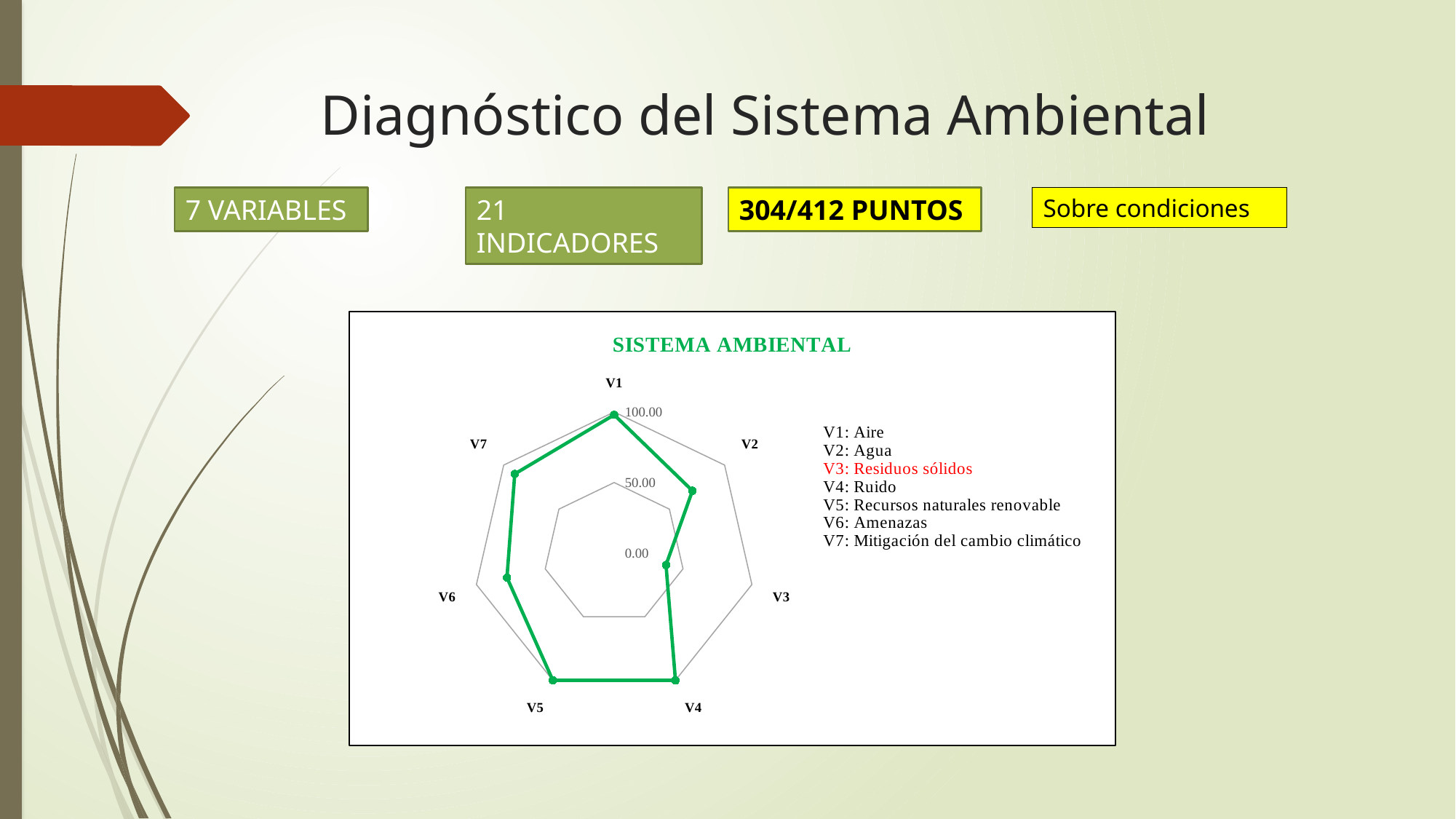
Which has a larger value, V3 or V7? V7 Which variable has the lowest value on the radar chart? V3 How many variables (axes) does the radar chart have? 7 Which has a larger value, V3 or V4? V4 Is the value for V6 greater or less than 50.00? greater What type of chart is shown on the slide? Radar chart Which has a larger value, V6 or V1? V1 Is the value for V3 greater or less than 50.00? less What is the maximum value shown on the radar chart's axis scale? 100.00 What is the title of the chart? SISTEMA AMBIENTAL Is the value for V2 greater or less than 50.00? greater